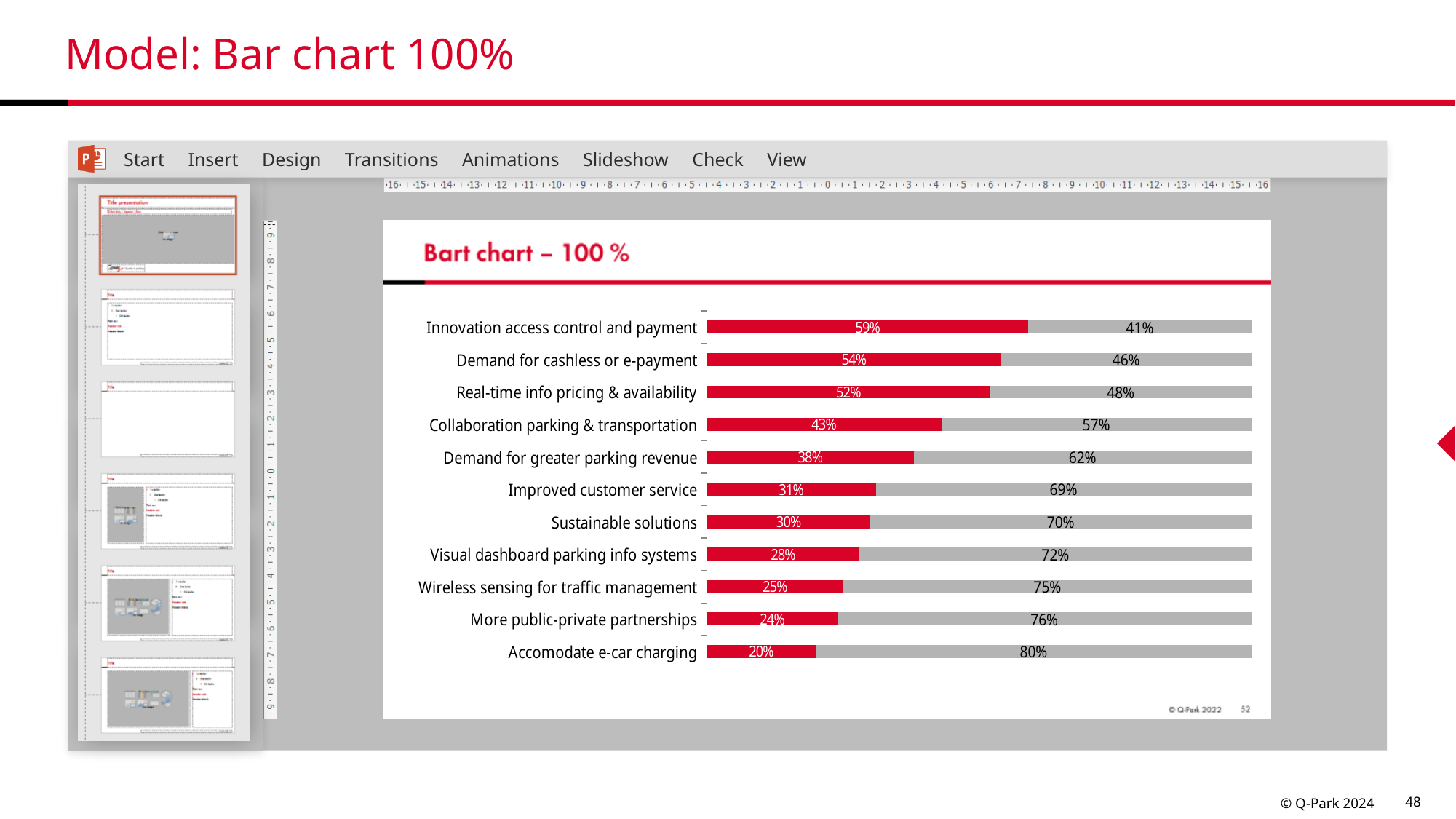
What kind of chart is shown? Bar chart Which has a larger red segment value: "Improved customer service" or "Demand for greater parking revenue"? Demand for greater parking revenue Which category has the highest red segment value? Innovation access control and payment Which category has the lowest red segment value? Accomodate e-car charging What is the grey segment value for "Wireless sensing for traffic management"? 75% What is the red segment value for "Innovation access control and payment"? 59% What is the grey segment value for "Accomodate e-car charging"? 80% What is the title of the chart shown in the screenshot? Bart chart – 100 % What is the red segment value for "Sustainable solutions"? 30% What is the total of the two segments for "Collaboration parking & transportation"? 100% What is the difference between the red segment values for "Demand for cashless or e-payment" and "Real-time info pricing & availability"? 2% How many categories are shown in the chart? 11